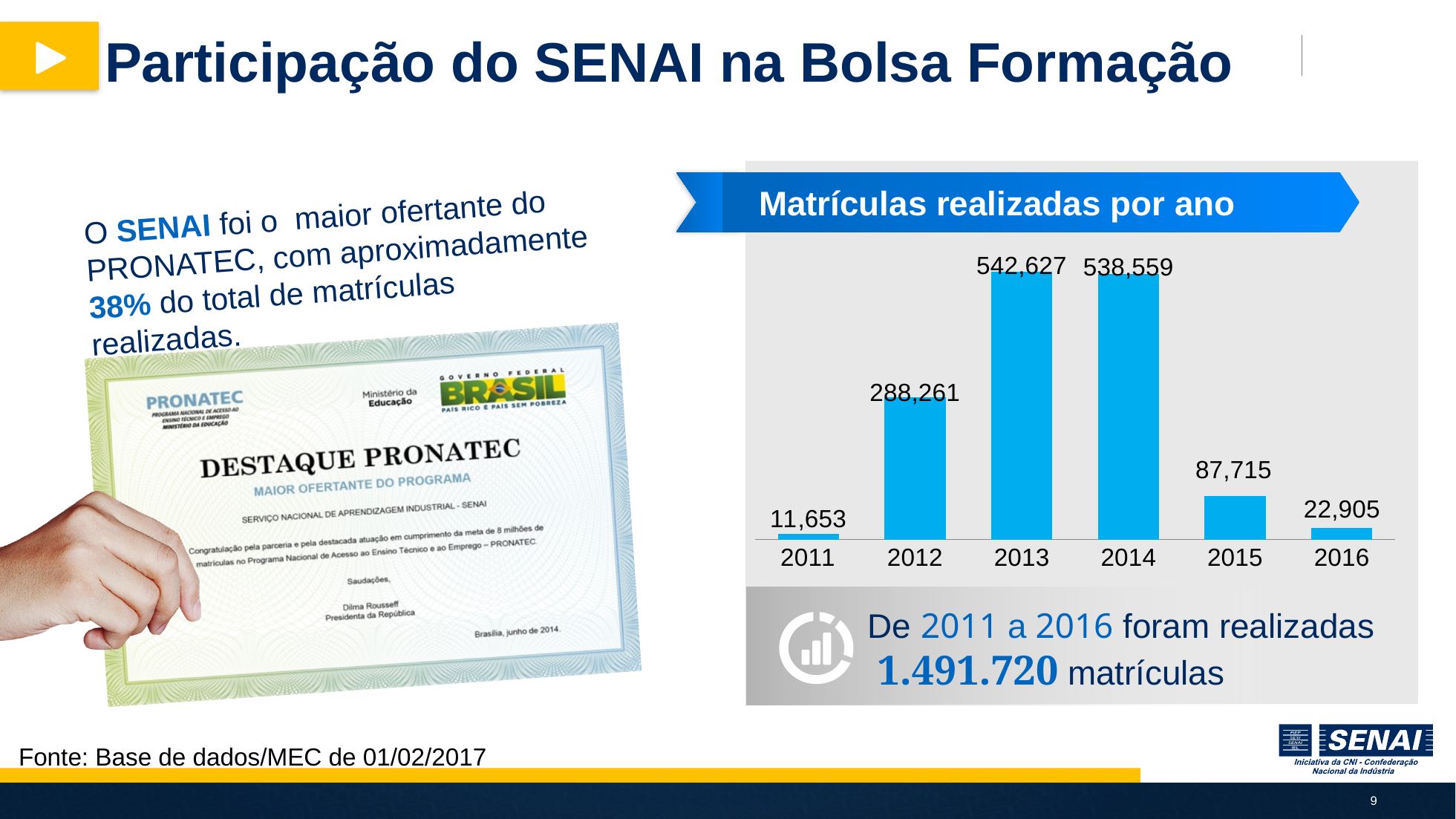
Which year has the larger value in the chart, 2015 or 2016? 2015 What is the value shown for 2011 in the chart? 11,653 What is the title of the chart on the slide? Matrículas realizadas por ano Which year has the highest number of enrolments in the chart? 2013 How do the values in the chart change from 2014 to 2016? They fall What is the value shown for 2015 in the chart? 87,715 What is the difference between the 2013 and 2014 values in the chart? 4,068 How many enrolments (matrículas) were made in 2013 according to the chart? 542,627 What is the difference between the 2012 and 2011 values in the chart? 276,608 Which year has the lowest number of enrolments in the chart? 2011 What type of chart is shown under the title 'Matrículas realizadas por ano'? bar chart How many years are shown on the x axis of the chart? 6